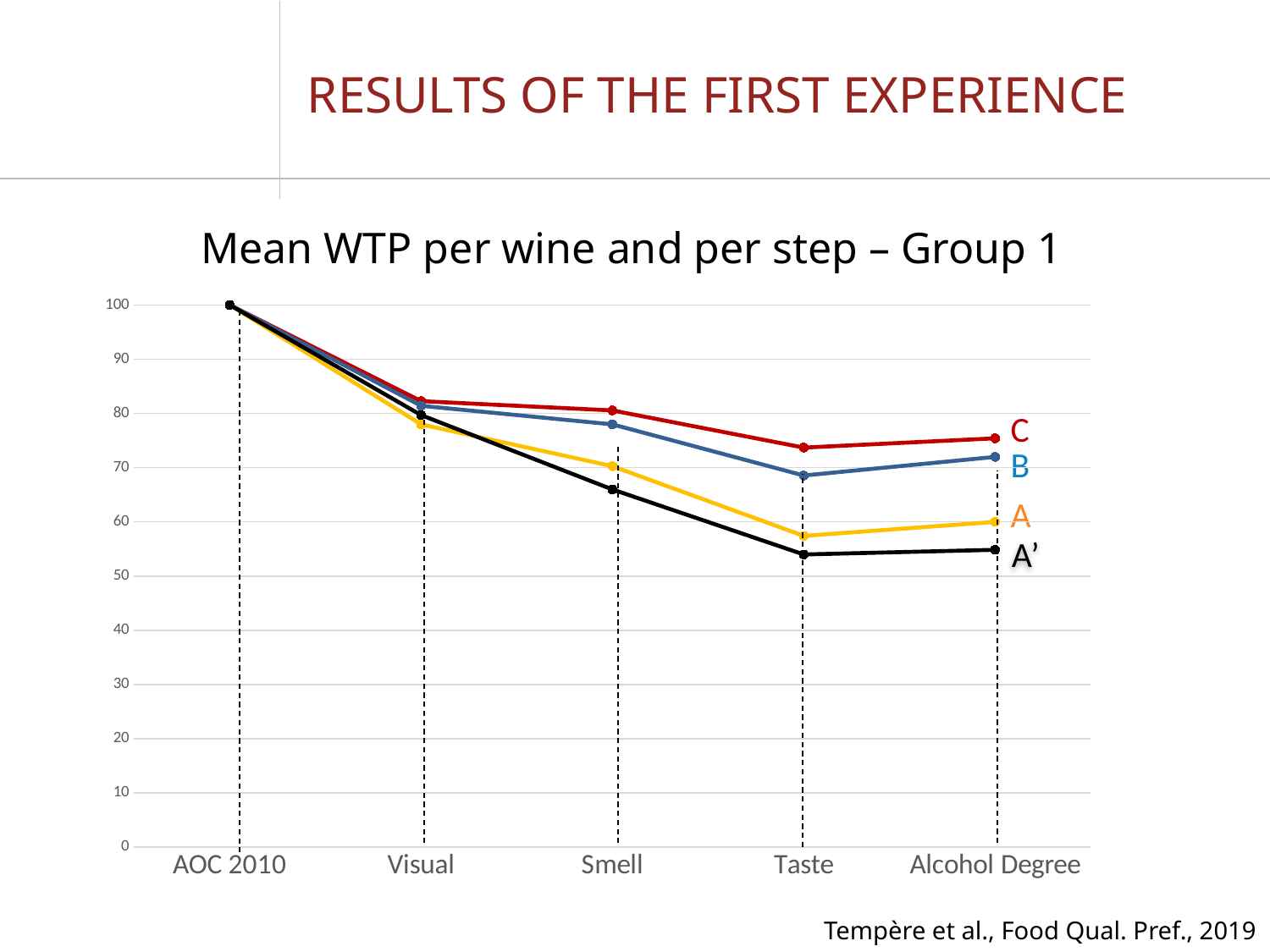
Is the mean WTP for wine C at the Taste step greater or less than 70? greater Which wine has the lowest mean WTP at the Taste step? A' What kind of chart is shown on the slide? line chart What is the title of the chart? Mean WTP per wine and per step – Group 1 How many steps are shown along the x axis of the chart? 5 Do the mean WTP values for wine A' rise or fall from AOC 2010 to Taste? fall At the Smell step, which wine has the larger mean WTP, B or A? B How many wine series (lines) are plotted on the chart? 4 Is the mean WTP for wine A' at the Smell step greater or less than 70? less What is the mean WTP for wine C at the AOC 2010 step? 100 Is the mean WTP for wine A at the Taste step greater or less than 60? less Which wine has the highest mean WTP at the Alcohol Degree step? C